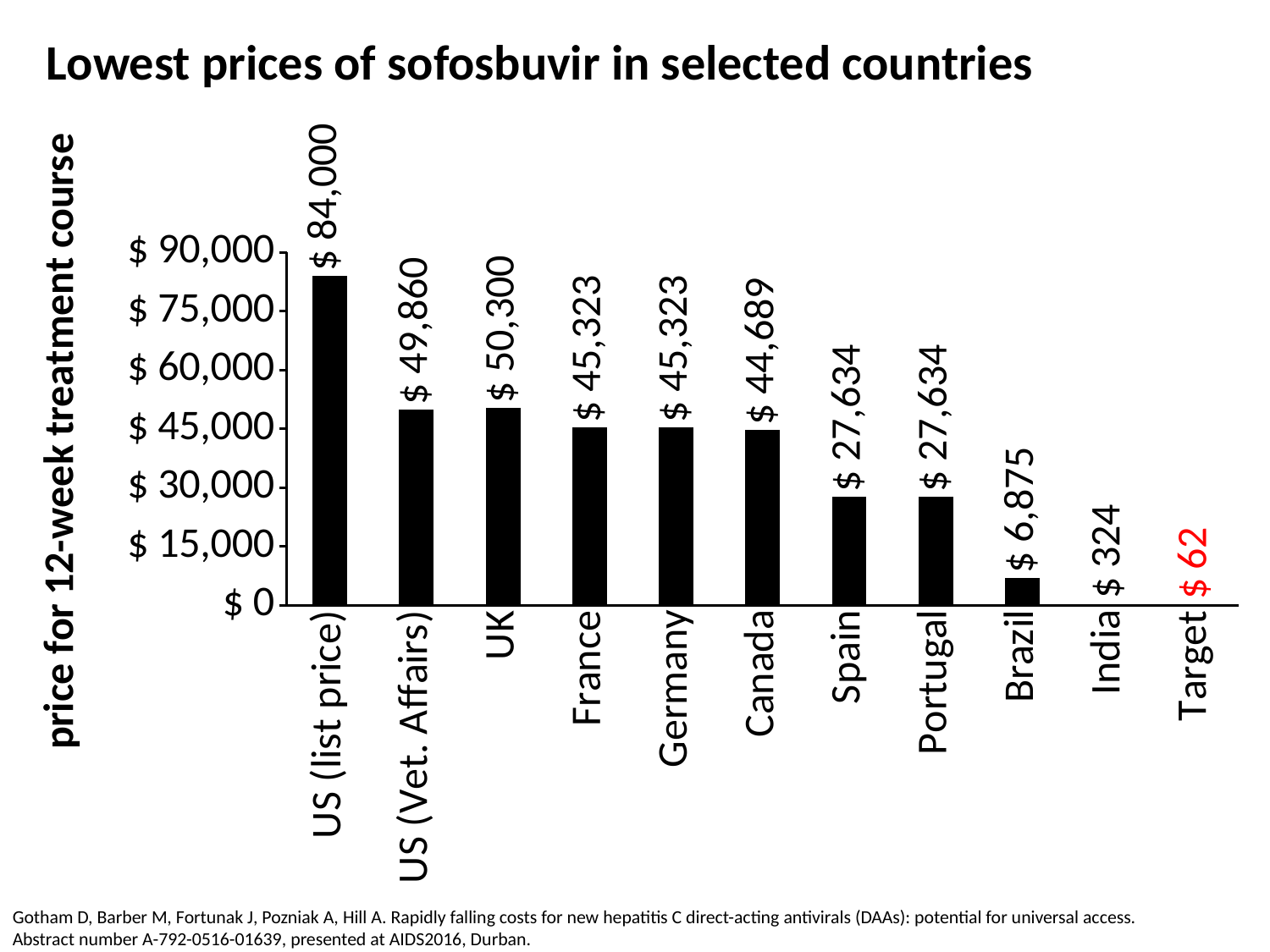
How many bars (categories) are shown on the chart? 11 What type of chart is shown on the slide? Bar chart What is the price shown for India? $ 324 Which category has the highest price? US (list price) What is the price for a 12-week treatment course of sofosbuvir in the UK? $ 50,300 What is the difference between the US list price and the US (Vet. Affairs) price? $ 34,140 Which is larger, the price in the UK or the price for US (Vet. Affairs)? UK Is the price for Canada greater or less than $ 30,000? greater Which country has the lowest price among the countries shown (excluding Target)? India What is the price shown for Brazil? $ 6,875 What is the Target price shown on the chart? $ 62 What is the title of the chart? Lowest prices of sofosbuvir in selected countries